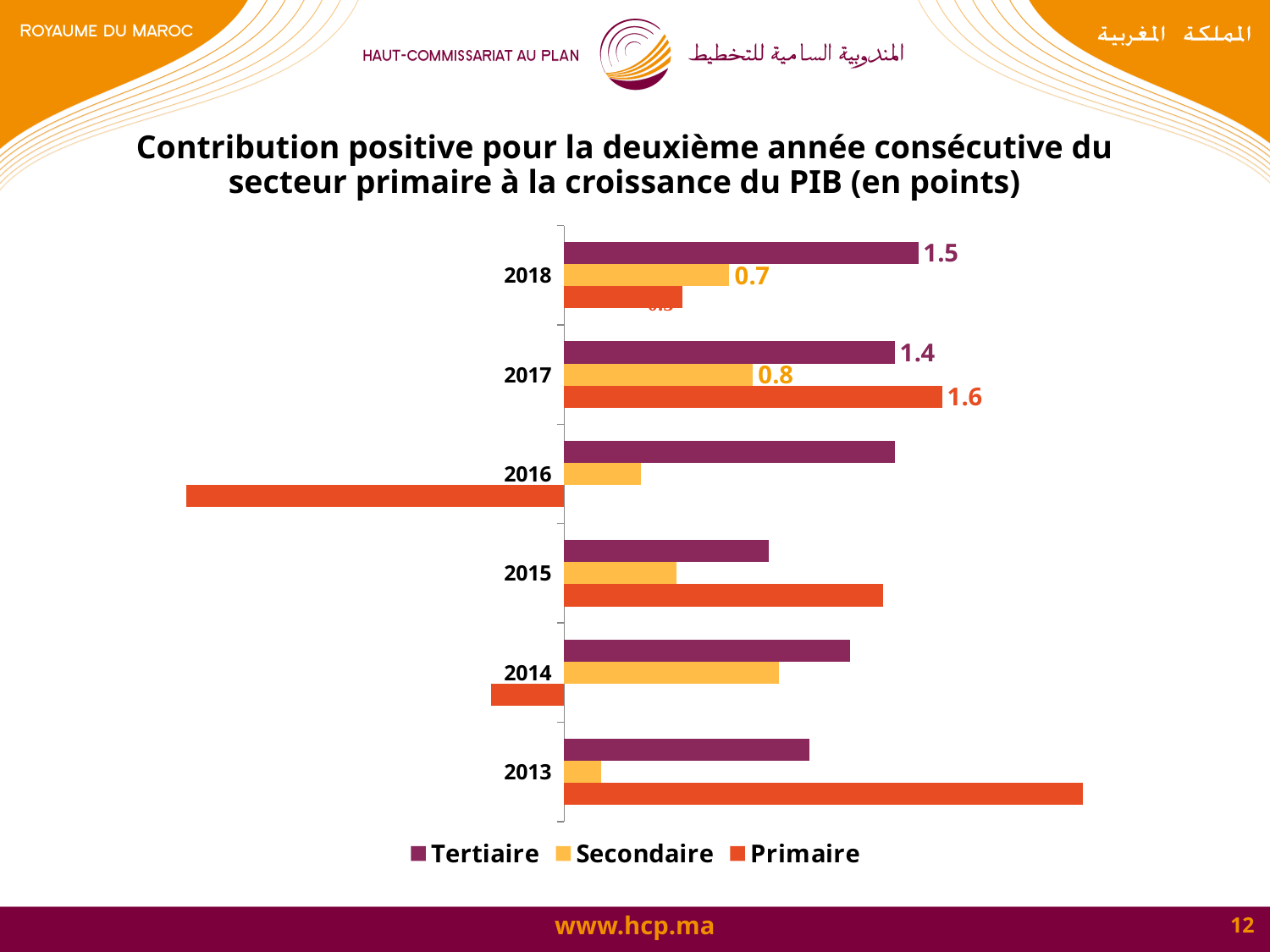
In which year is the Primaire contribution the most negative? 2016 What is the value for Tertiaire in 2018? 1.5 What is the difference between the Tertiaire and Secondaire values in 2018? 0.8 How many years are shown on the chart? 6 What kind of chart is shown on the slide? Bar chart What is the value for Secondaire in 2018? 0.7 Which sector has the highest contribution in 2017? Primaire What is the value for Tertiaire in 2017? 1.4 What is the value for Primaire in 2017? 1.6 How many series does the legend list? 3 Which is larger in 2017, the Primaire value or the Tertiaire value? Primaire What is the value for Secondaire in 2017? 0.8